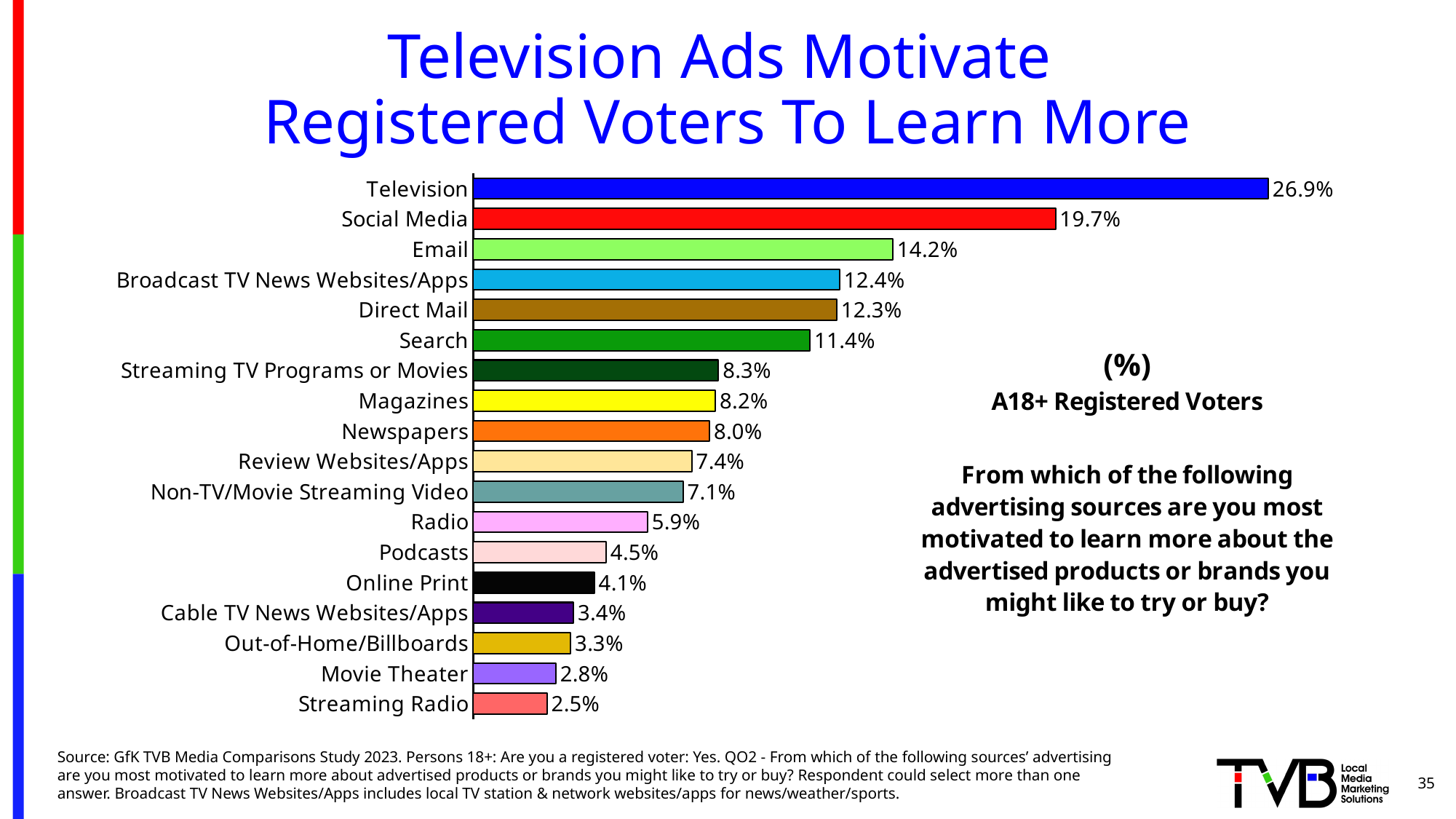
Which is larger, the value for Radio or the value for Online Print? Radio What is the value for Television? 26.9% What is the difference between the values for Email and Search? 2.8% Which category has the lowest value? Streaming Radio What is the value for Direct Mail? 12.3% What is the difference between the values for Television and Social Media? 7.2% What colour is the bar for Magazines? Yellow What kind of chart is shown on the slide? Bar chart What is the value for Podcasts? 4.5% Which category has the highest value? Television Do the values rise or fall going down the list of categories from Television to Streaming Radio? Fall How many categories are shown in the chart? 18